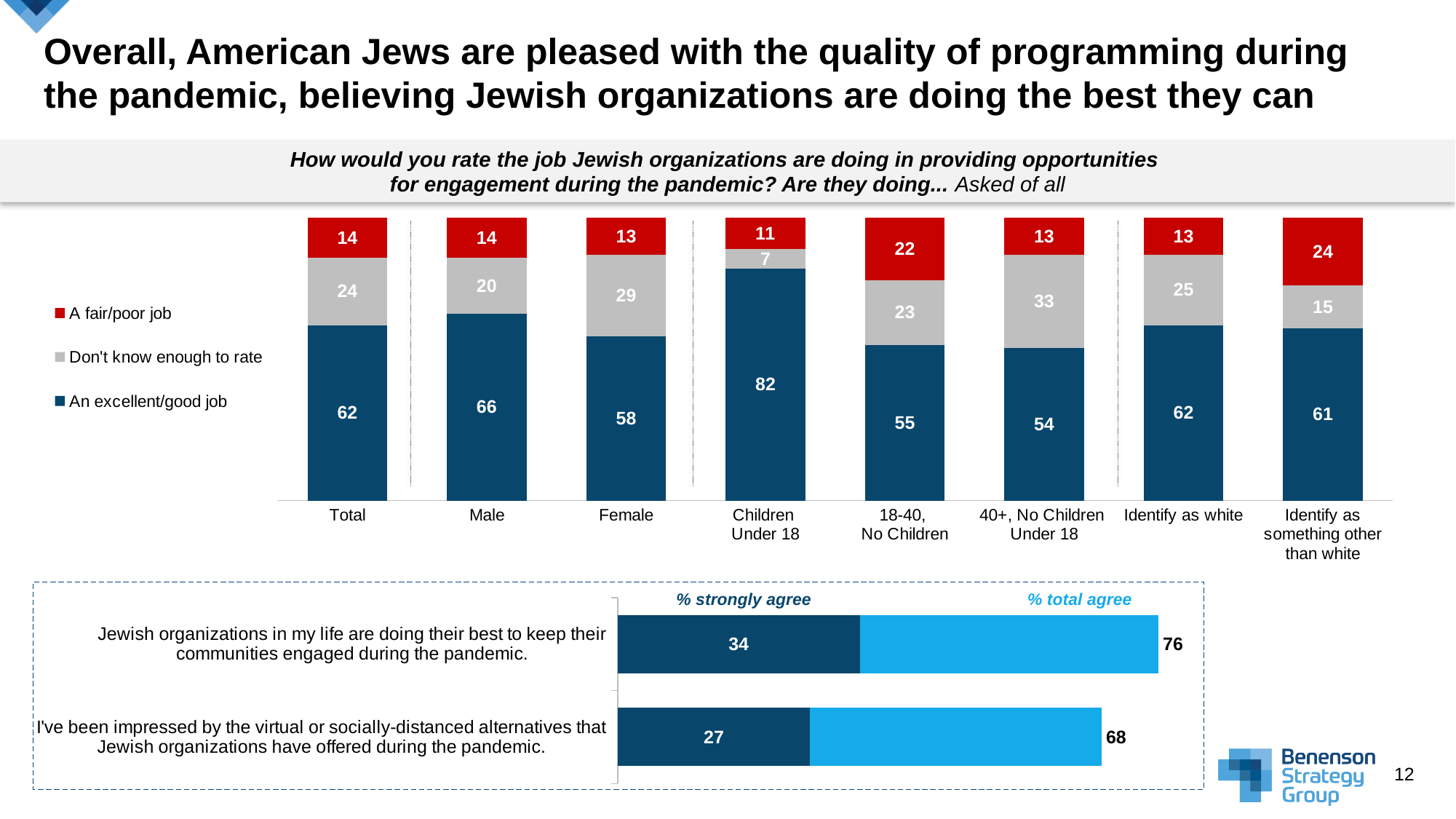
In the top chart, which group has the lowest 'An excellent/good job' value? 40+, No Children Under 18 What kind of chart is the top chart? Stacked bar chart In the bottom chart, what is the difference between the '% total agree' values of the two statements? 8 In the bottom chart, what is the '% strongly agree' value for the statement 'Jewish organizations in my life are doing their best to keep their communities engaged during the pandemic'? 34 In the top chart, which group has a larger 'A fair/poor job' value: 18-40, No Children or Identify as white? 18-40, No Children In the top chart, what is the difference between the 'An excellent/good job' values for Male and Female? 8 In the top chart, what is the 'Don't know enough to rate' value for the 40+, No Children Under 18 group? 33 In the top chart, how many series does the legend list? 3 In the top chart, which group has the highest 'An excellent/good job' value? Children Under 18 In the top chart, how many groups are shown along the x axis? 8 In the bottom chart, what is the '% total agree' value for the statement 'I've been impressed by the virtual or socially-distanced alternatives that Jewish organizations have offered during the pandemic'? 68 In the top chart, what percentage of the Total group say Jewish organizations are doing an excellent/good job? 62